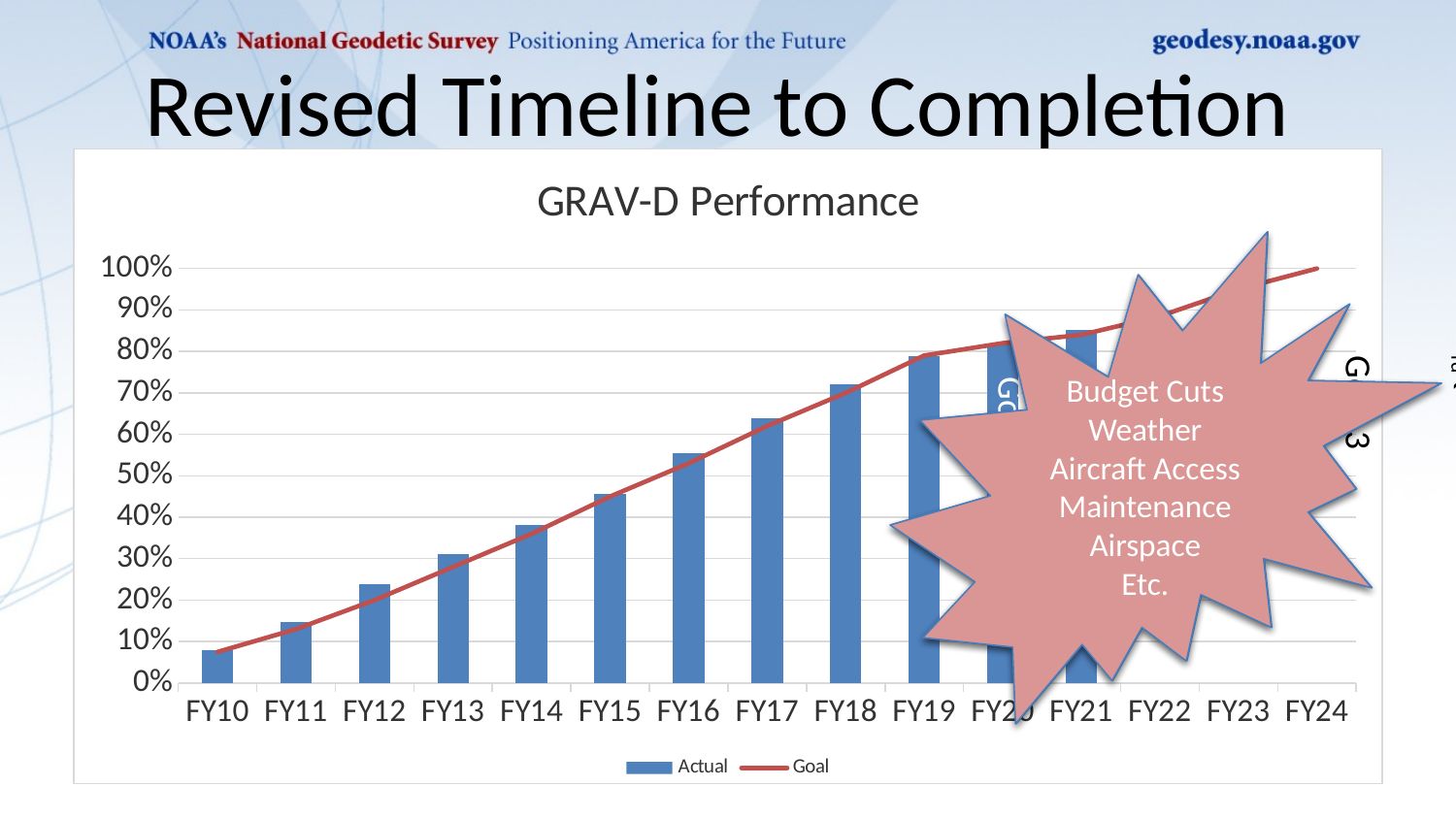
What is the title of the chart on the slide? GRAV-D Performance Is the Actual value for FY14 greater or less than 40%? less Is the Actual value for FY18 greater or less than 70%? greater What are the two series named in the legend of the GRAV-D Performance chart? Actual and Goal Do the Actual bars rise or fall from FY10 to FY21 in the GRAV-D Performance chart? rise Is the Actual value for FY10 greater or less than 10%? less What kind of chart is used to show the Actual series in the GRAV-D Performance chart? bar chart Which fiscal year has the lowest Actual bar in the GRAV-D Performance chart? FY10 How many series does the legend of the GRAV-D Performance chart list? 2 How many fiscal years are shown on the x axis of the GRAV-D Performance chart? 15 Which has the larger Actual value, FY12 or FY16? FY16